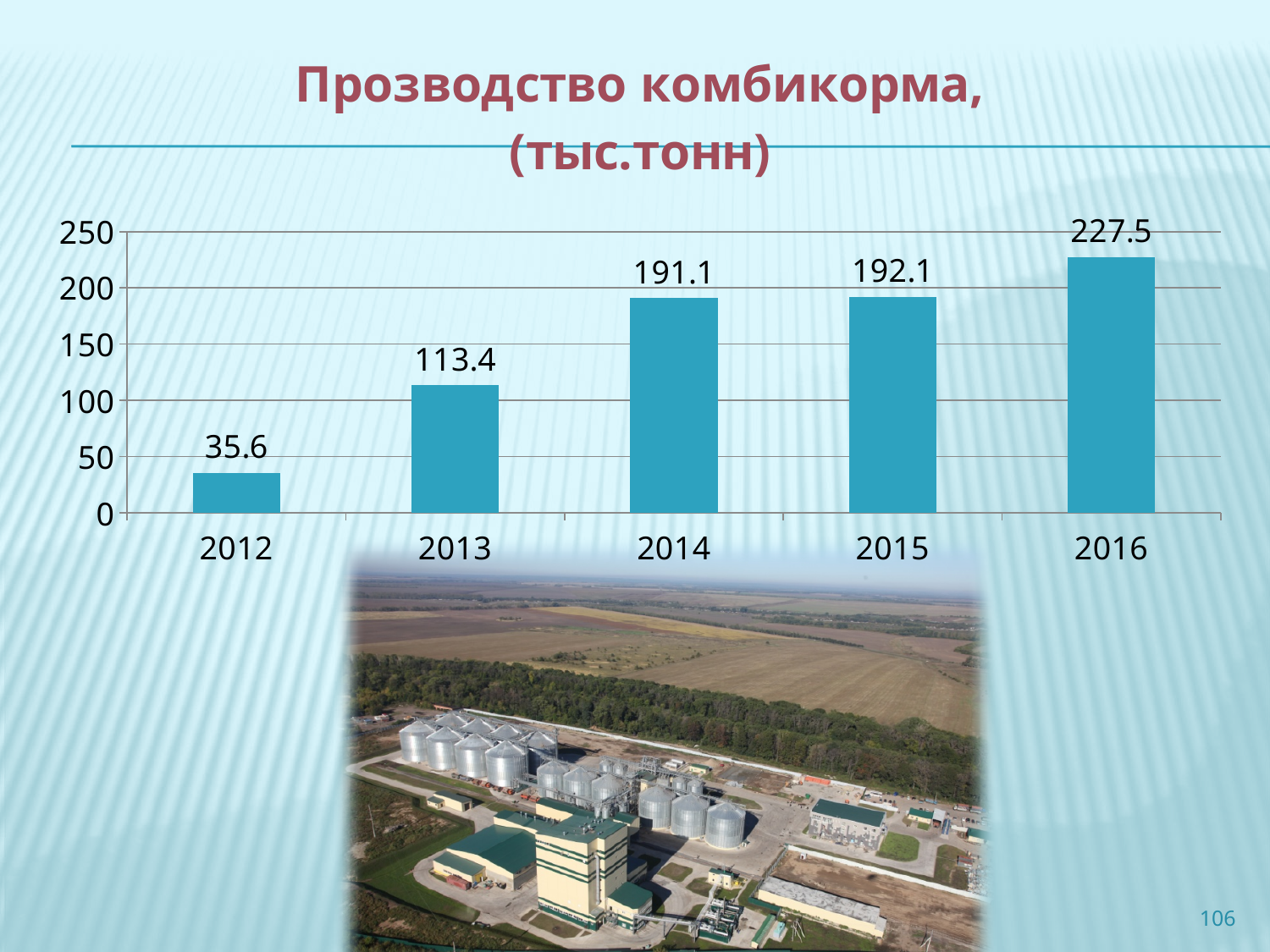
How many years are shown on the chart? 5 Which year has the highest value? 2016 What is the difference between the values for 2013 and 2012? 77.8 What kind of chart is shown on the slide? bar chart What is the value for 2016? 227.5 Which is larger, the value for 2013 or the value for 2014? 2014 What is the difference between the values for 2016 and 2015? 35.4 What is the value for 2014? 191.1 What is the value for 2012? 35.6 Is the value for 2013 greater or less than 100? greater Which year has the lowest value? 2012 Do the values rise or fall from 2012 to 2016? rise